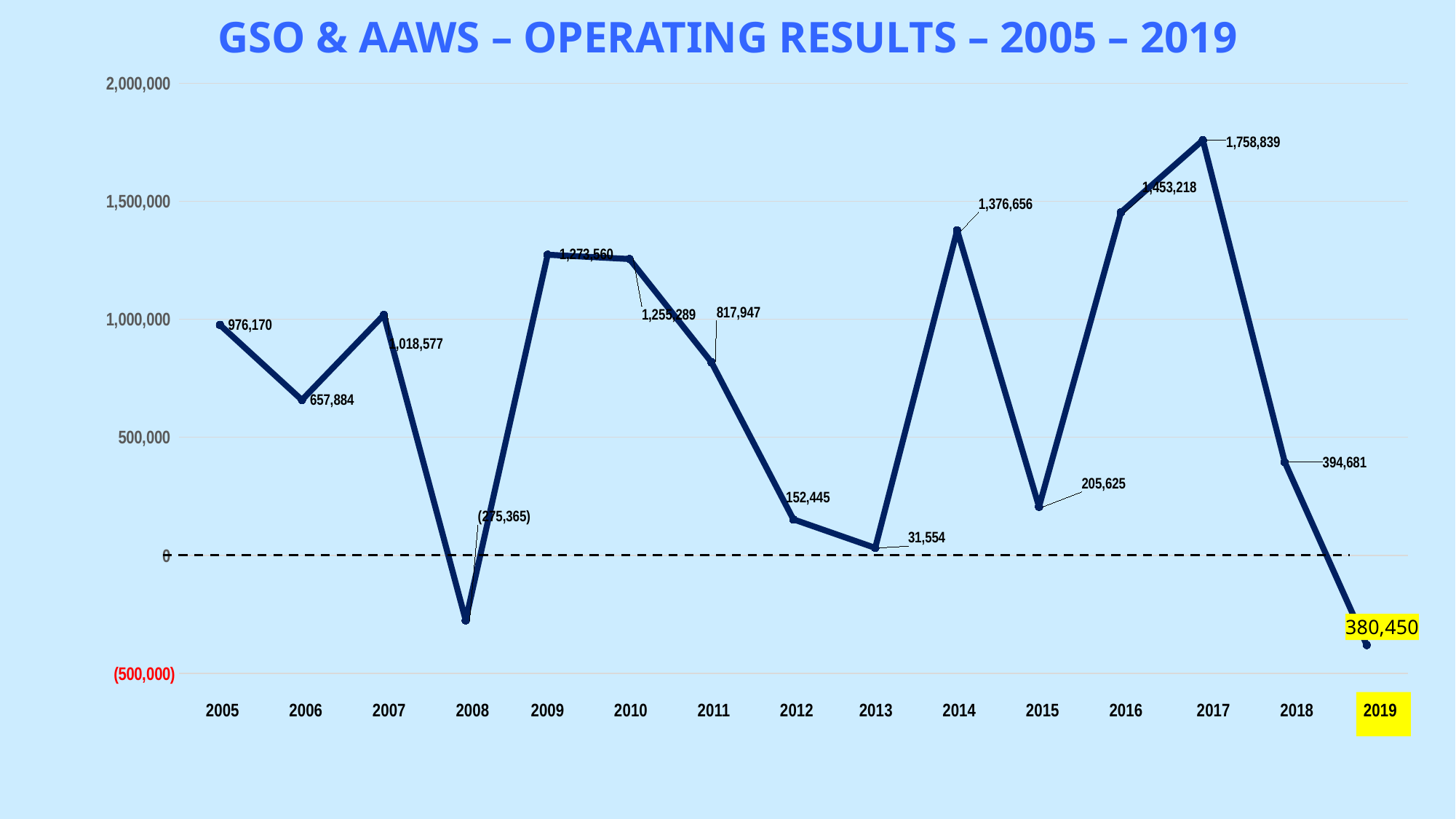
Which year has the lowest point on the line? 2019 How many years are plotted on the x axis? 15 What kind of chart is shown on the slide? line chart What is the difference between the 2017 and 2016 operating results? 305,621 What is the operating result for 2013? 31,554 What value is shown in the yellow highlighted label for 2019? 380,450 What is the operating result for 2017? 1,758,839 Is the value for 2011 greater or less than 1,000,000? less What is the operating result for 2008? (275,365) Do the values rise or fall from 2017 to 2019? fall Which year has the larger operating result, 2014 or 2016? 2016 Which year has the highest operating result? 2017